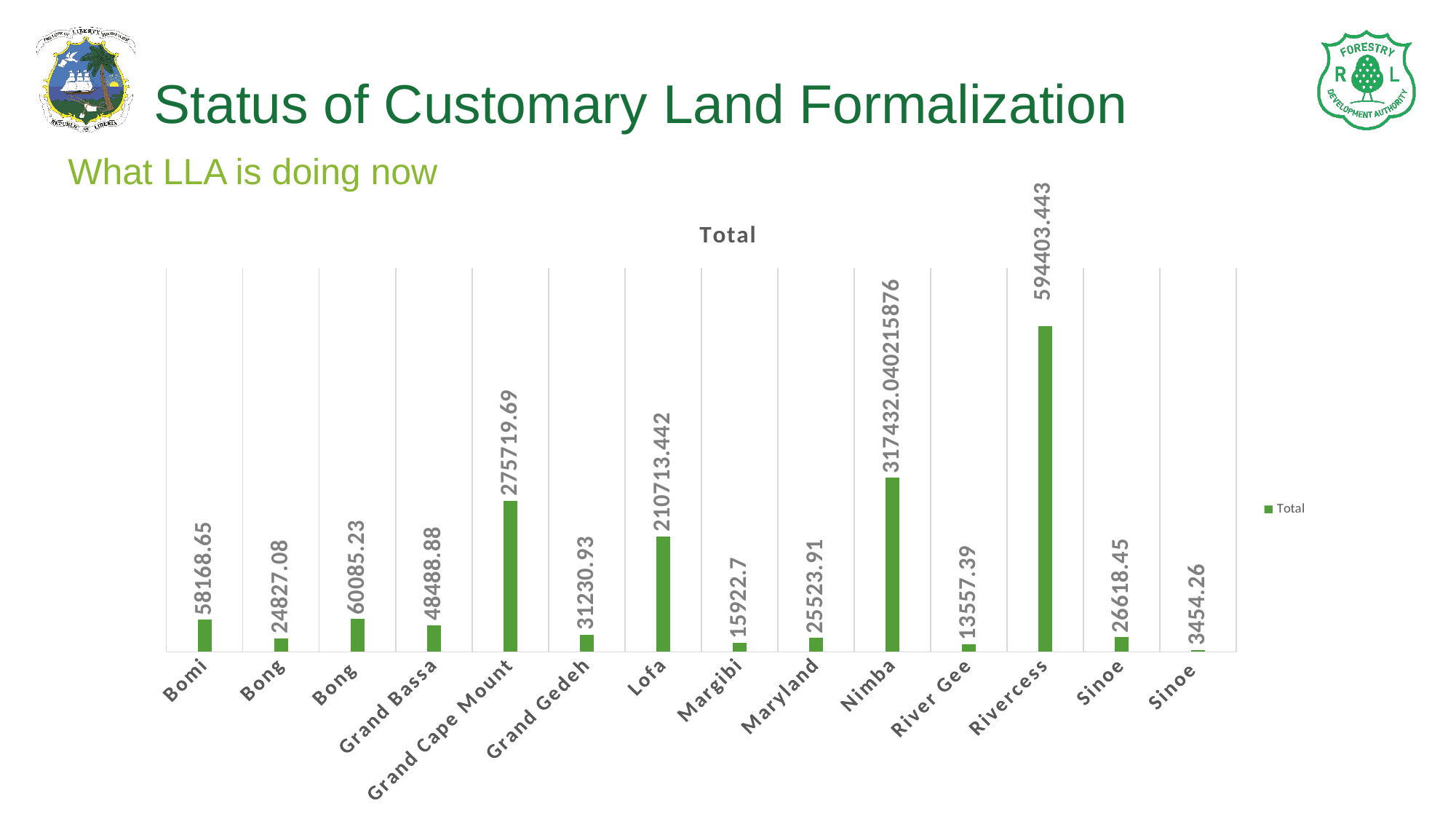
How many series does the legend list? 1 What type of chart is shown on the slide? bar chart What is the value for Grand Cape Mount? 275719.69 What is the title of the chart? Total What is the difference between the values for Grand Cape Mount and Lofa? 65006.248 What is the lowest value shown in the chart? 3454.26 What is the value for Bomi? 58168.65 Which category has the highest value? Rivercess What is the value for River Gee? 13557.39 How many bars are plotted in the chart? 14 What is the value for Nimba? 317432.040215876 Which is larger, the value for Lofa or the value for Grand Cape Mount? Grand Cape Mount